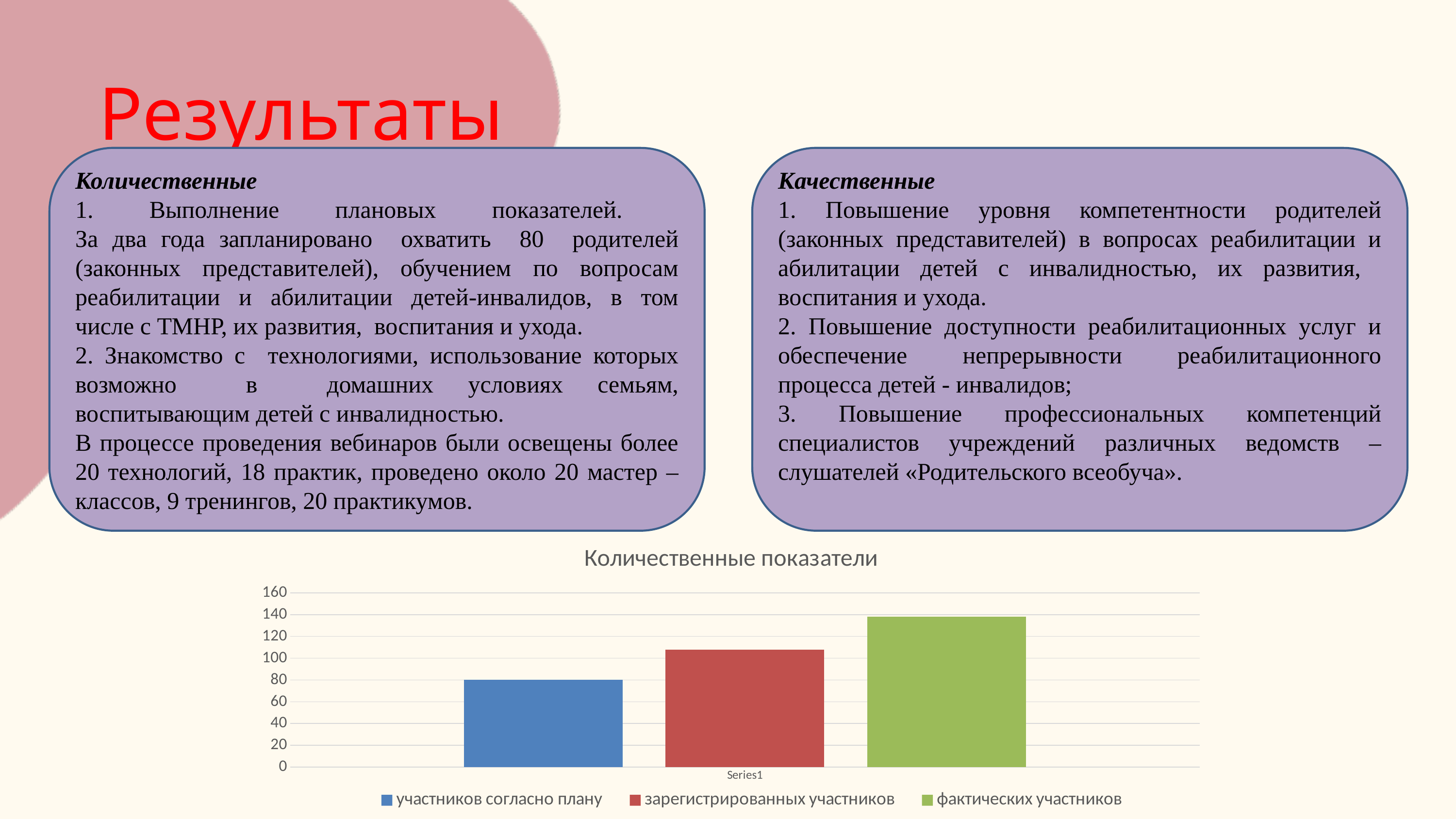
Is the value for "зарегистрированных участников" greater or less than 100? greater What is the value for "участников согласно плану" in the "Количественные показатели" chart? 80 What is the title of the chart on the slide? Количественные показатели What kind of chart is shown under the title "Количественные показатели"? bar chart Which is larger: "участников согласно плану" or "зарегистрированных участников"? зарегистрированных участников Which is larger: "зарегистрированных участников" or "фактических участников"? фактических участников Which series has the highest value in the "Количественные показатели" chart? фактических участников How many series does the legend of the "Количественные показатели" chart list? 3 Which series has the lowest value in the "Количественные показатели" chart? участников согласно плану What colour is the bar for "фактических участников"? green Is the value for "зарегистрированных участников" greater or less than 120? less